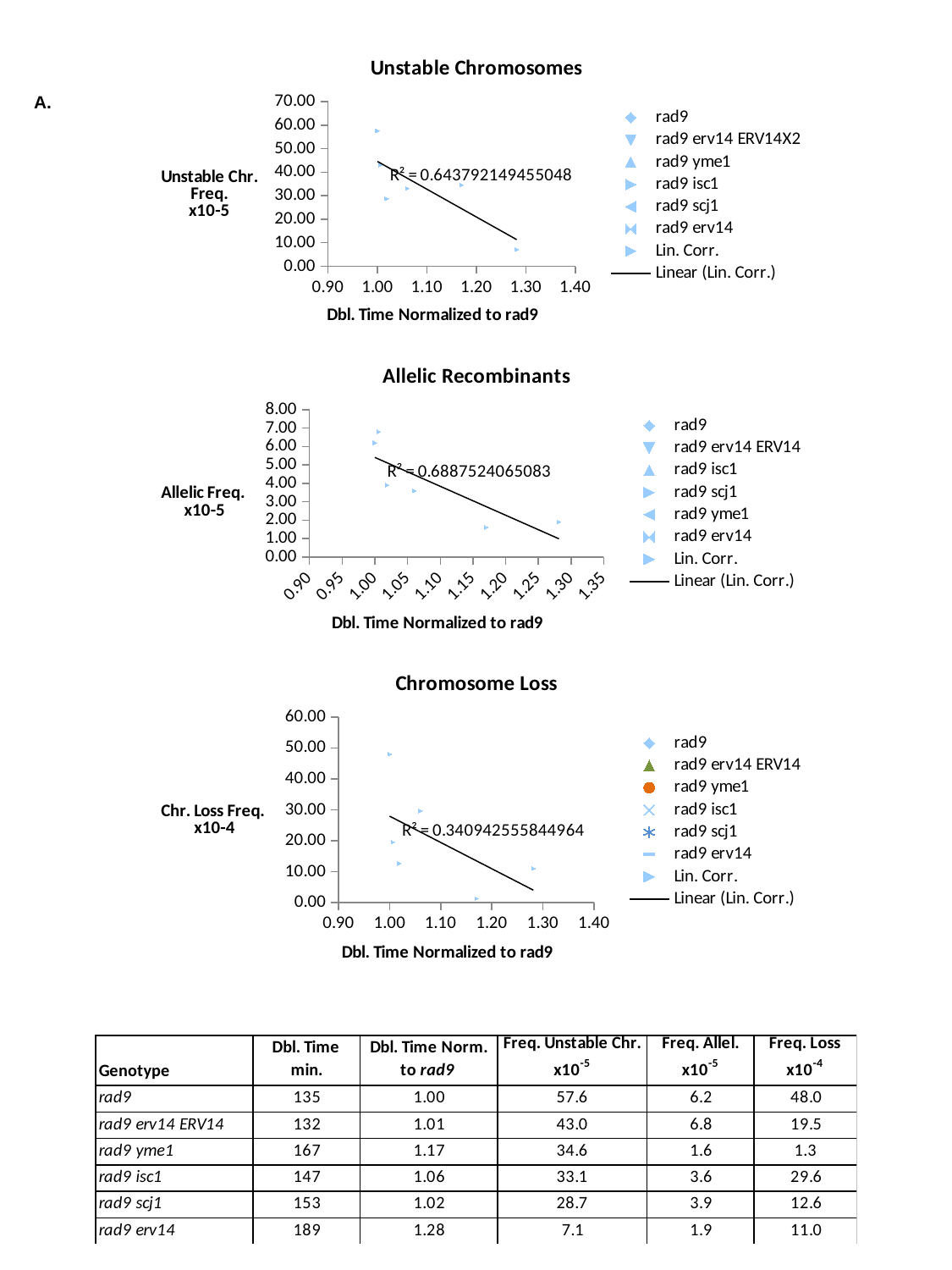
In the "Allelic Recombinants" chart, what R² value is printed next to the trend line? 0.6887524065083 In the "Unstable Chromosomes" chart, is the point plotted at a normalized doubling time of about 1.28 greater or less than 10? less In the "Unstable Chromosomes" chart, do the plotted values rise or fall as the normalized doubling time increases? Fall What kind of chart is the "Unstable Chromosomes" chart? Scatter chart How many entries does the legend of the "Unstable Chromosomes" chart list? 8 In the "Chromosome Loss" chart, is the highest plotted point greater or less than 40? greater How many data points are plotted in the "Allelic Recombinants" chart? 6 What is the x-axis title of the "Chromosome Loss" chart? Dbl. Time Normalized to rad9 In the "Unstable Chromosomes" chart, what R² value is printed next to the trend line? 0.643792149455048 In the "Allelic Recombinants" chart, is the point plotted at a normalized doubling time of about 1.17 greater or less than 2.00? less In the "Chromosome Loss" chart, what R² value is printed next to the trend line? 0.340942555844964 Which of the three charts shows the highest R² value? Allelic Recombinants